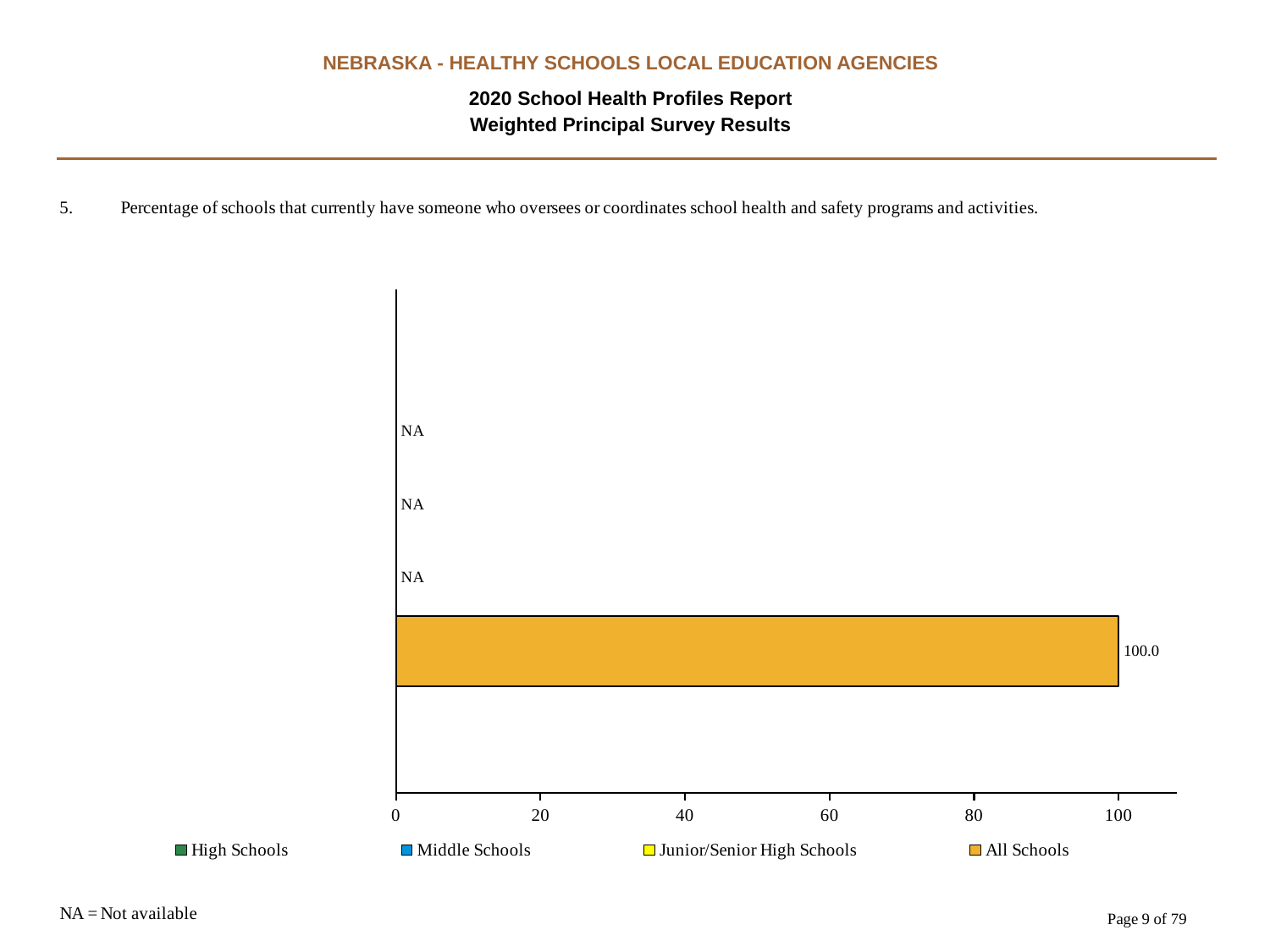
What is shown for High Schools? NA What kind of chart is shown on the slide? bar chart What is the highest value shown on the x axis? 100 Which series is the only one with a plotted bar? All Schools How many series does the legend list? 4 What is shown for Junior/Senior High Schools? NA What is shown for Middle Schools? NA What is the value for All Schools? 100.0 What does NA stand for according to the note on the slide? Not available How many series are marked NA? 3 Is the value for All Schools greater or less than 80? greater